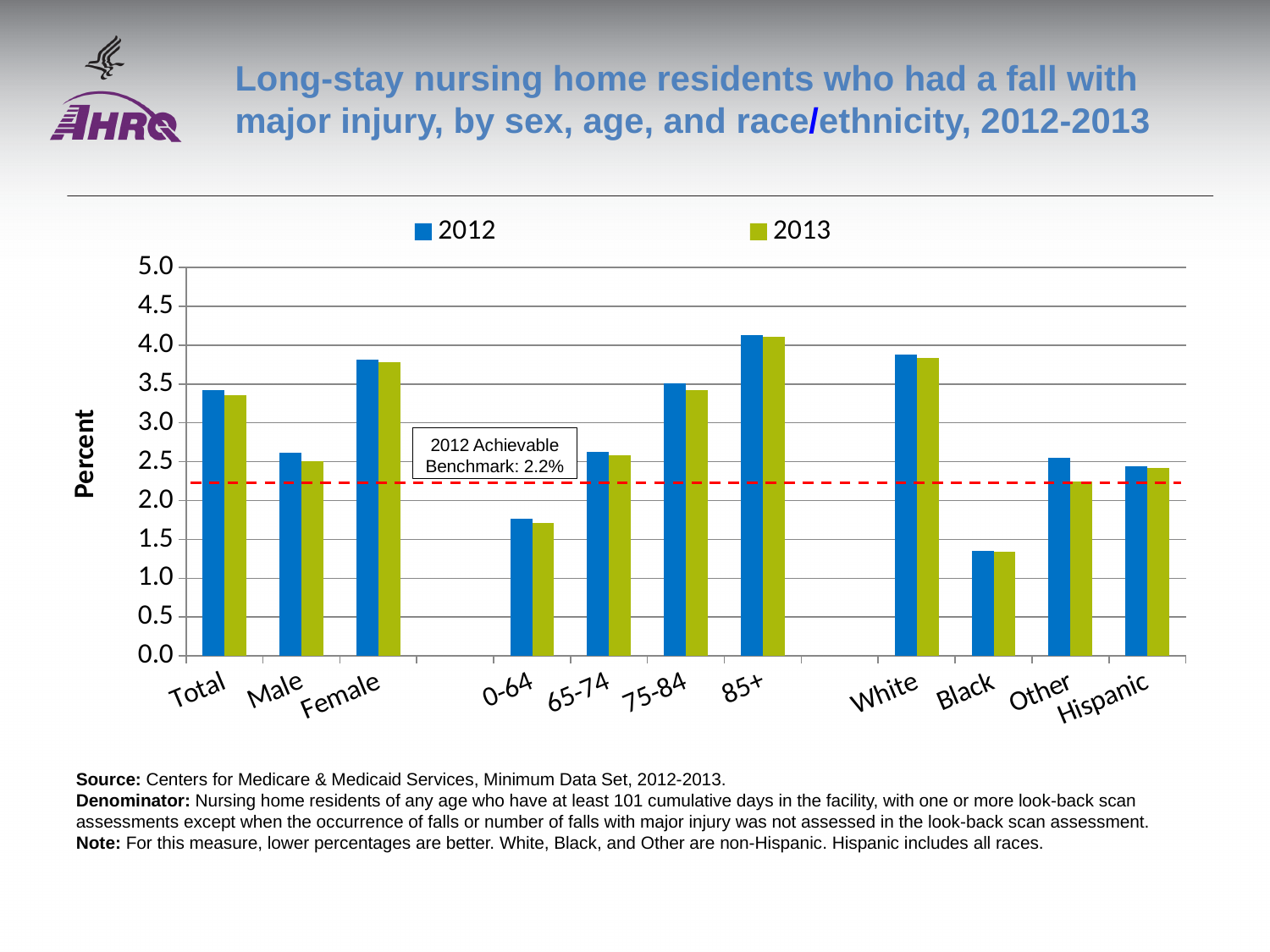
What kind of chart is shown on the slide? bar chart How many series does the legend list? 2 Is the 2013 value for 0-64 greater or less than 2.0? less Is the 2012 value for White greater or less than 3.5? greater How many categories are shown along the x axis? 11 Is the 2012 value for Female greater or less than 3.5? greater What is the 2012 Achievable Benchmark shown by the dashed line? 2.2% Which category has the highest value for 2012? 85+ Which is larger for 2012, the value for Female or the value for Male? Female Do the values rise or fall across the age groups from 0-64 to 85+? rise Which category has the lowest value for 2013? Black